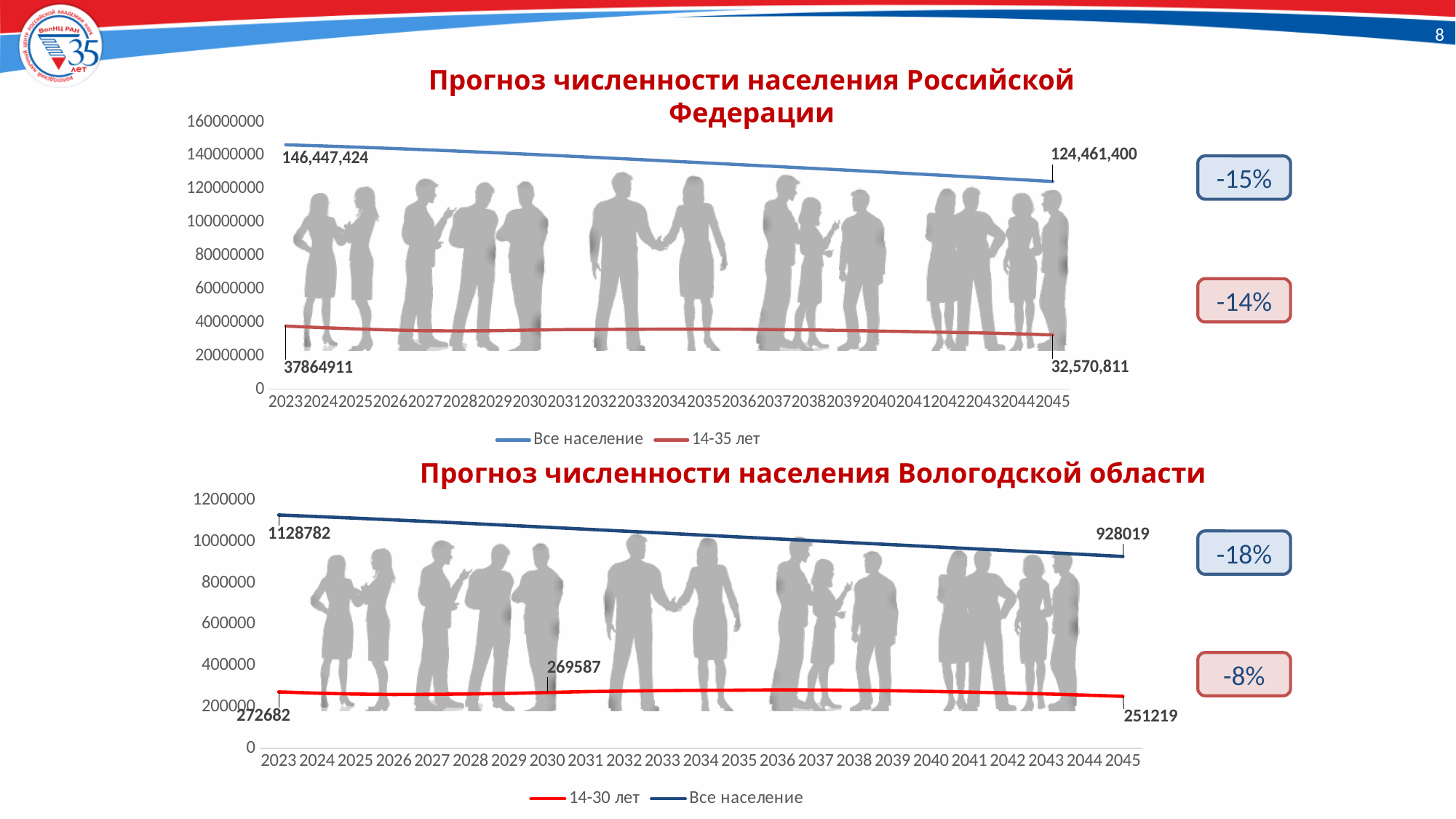
In the chart titled "Прогноз численности населения Вологодской области", what is the value of "14-30 лет" in 2045? 251219 In the chart titled "Прогноз численности населения Российской Федерации", is the value of "14-35 лет" in 2035 greater or less than 60000000? less In the chart titled "Прогноз численности населения Вологодской области", what is the difference between the "Все население" values in 2023 and 2045? 200763 In the chart titled "Прогноз численности населения Российской Федерации", does the "Все население" series rise or fall from 2023 to 2045? fall In the chart titled "Прогноз численности населения Российской Федерации", what is the value of "14-35 лет" in 2045? 32,570,811 In the chart titled "Прогноз численности населения Вологодской области", what is the value of "Все население" in 2023? 1128782 In the chart titled "Прогноз численности населения Российской Федерации", what is the value of "Все население" in 2023? 146,447,424 In the chart titled "Прогноз численности населения Вологодской области", how many years are shown on the x axis? 23 In the chart titled "Прогноз численности населения Российской Федерации", how many series does the legend list? 2 In the chart titled "Прогноз численности населения Российской Федерации", what is the value of "Все население" in 2045? 124,461,400 In the chart titled "Прогноз численности населения Вологодской области", what is the value of "14-30 лет" in 2030? 269587 What type of chart is the chart titled "Прогноз численности населения Вологодской области"? line chart